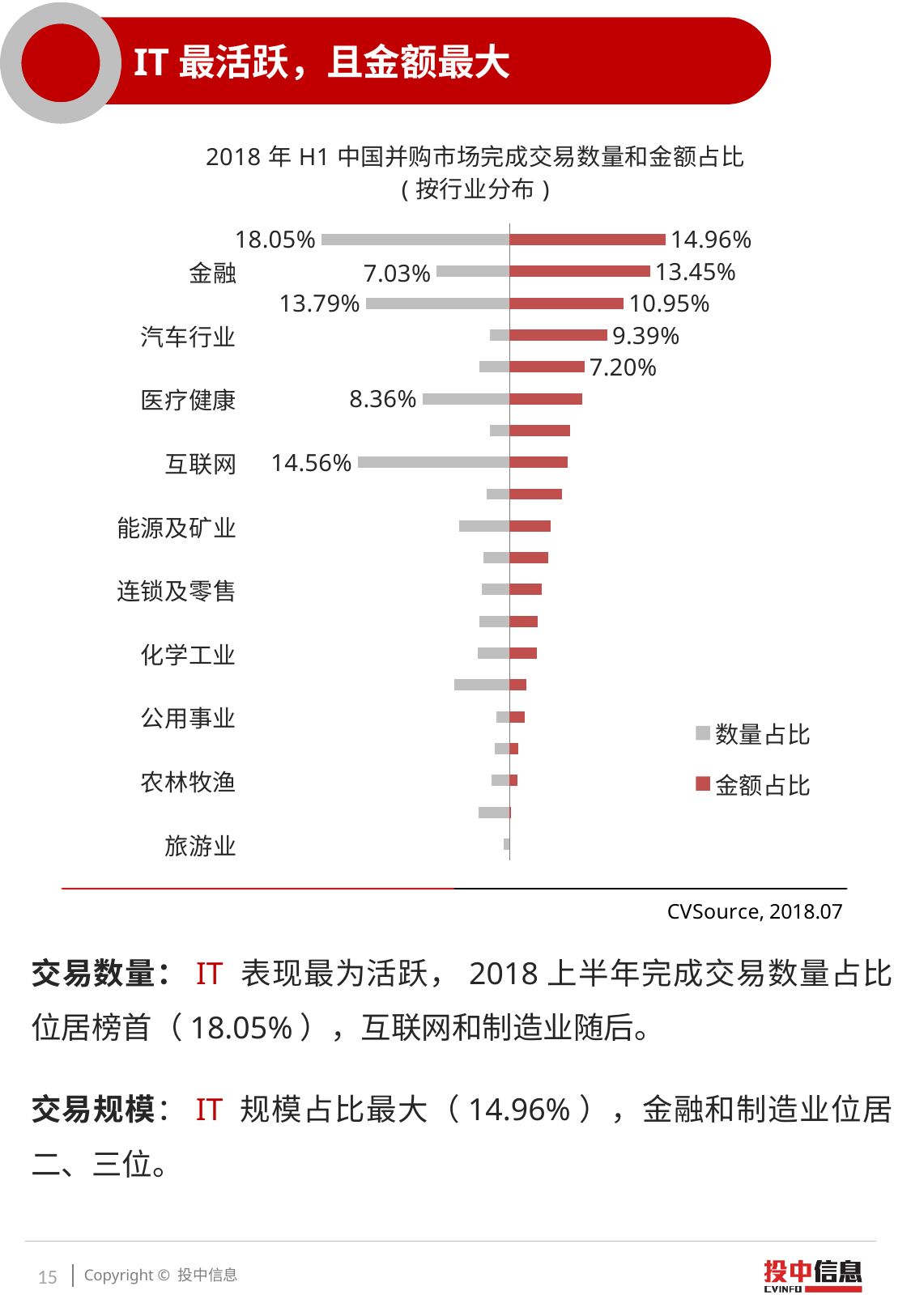
What is the 金额占比 value for 金融? 13.45% What is the largest 金额占比 value shown on the chart? 14.96% What is the 数量占比 value for 医疗健康? 8.36% What is the 金额占比 value for 汽车行业? 9.39% What kind of chart is shown on the slide? Bar chart What is the largest 数量占比 value shown on the chart? 18.05% For 金融, which is larger: 数量占比 or 金额占比? 金额占比 What is the difference between the 金额占比 and 数量占比 values for 金融? 6.42% What is the 数量占比 value for 互联网? 14.56% What is the 数量占比 value for 金融? 7.03% How many series does the legend list? 2 Which has the larger 数量占比: 互联网 or 医疗健康? 互联网